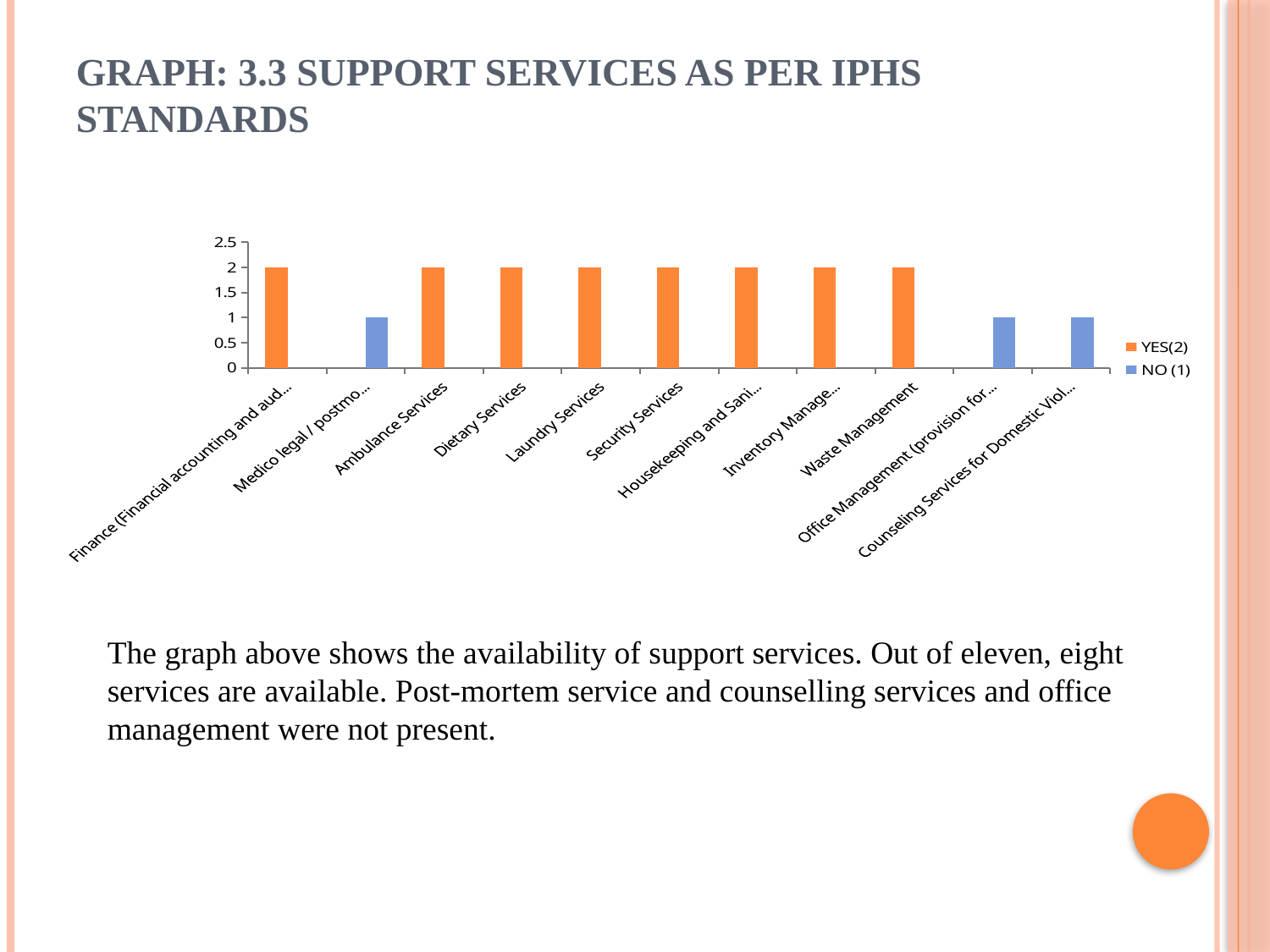
What are the two entries in the legend? YES(2) and NO (1) How many series does the legend list? 2 Is the value for Security Services greater or less than 1.5? greater Which is larger, the value for Dietary Services or the value for Office Management? Dietary Services What colour are the YES(2) bars? orange What is the value for Ambulance Services? 2 What is the difference between the value for Laundry Services and the value for Office Management? 1 What kind of chart is shown on the slide? bar chart What is the value for Waste Management? 2 How many categories are plotted along the x axis? 11 What is the value for Office Management? 1 How many categories have a NO (1) bar? 3